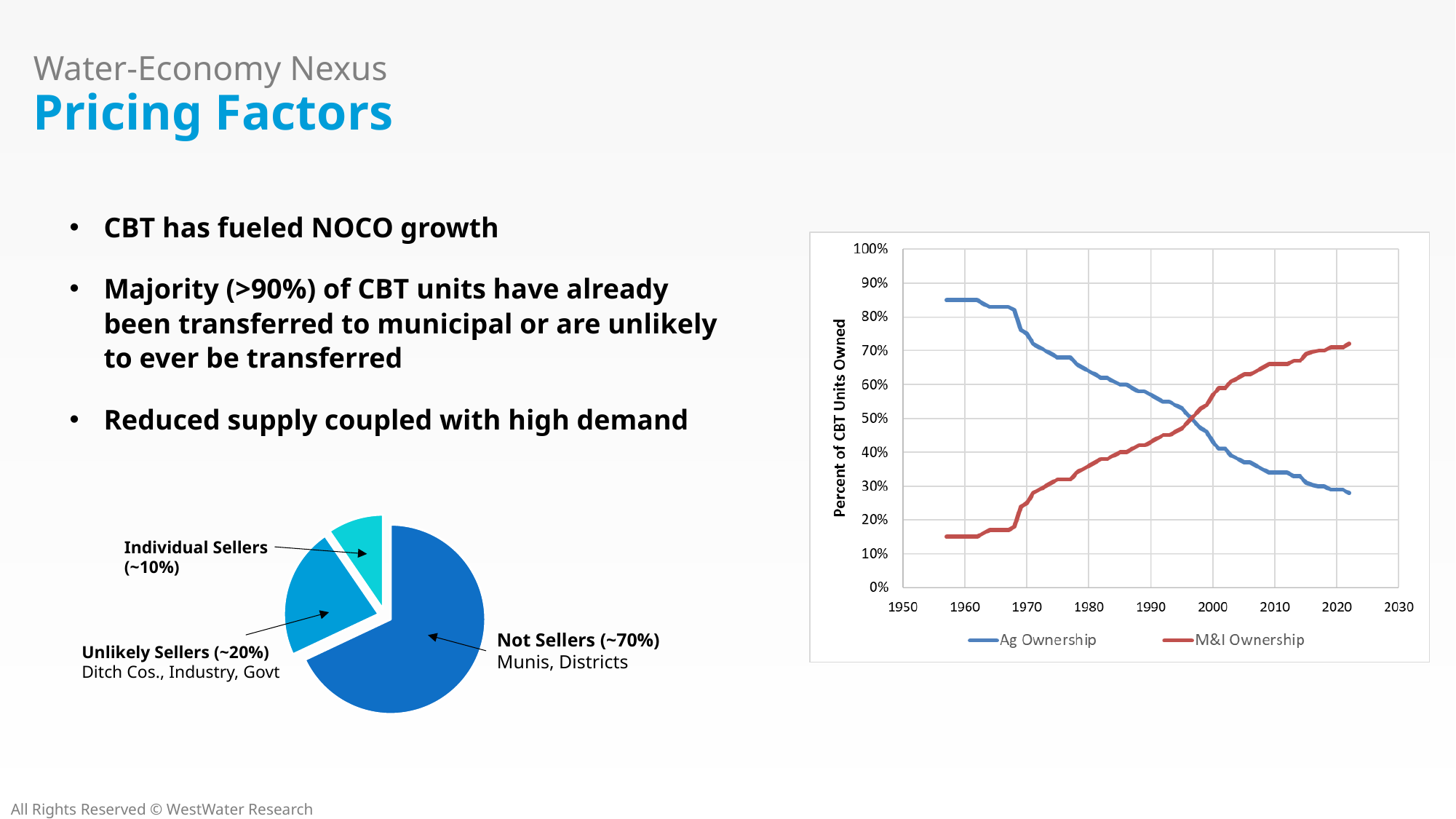
In the line chart on the right, does M&I Ownership rise or fall over time? rise What kind of chart is the chart on the right of the slide? line chart What kind of chart is the chart on the bottom left of the slide? pie chart In the line chart on the right, is the value for M&I Ownership in 1960 greater or less than 20%? less In the line chart on the right, is the value for M&I Ownership in 2010 greater or less than 60%? greater In the line chart on the right, does Ag Ownership rise or fall over time? fall In the line chart on the right, which series has the higher value in 1970, Ag Ownership or M&I Ownership? Ag Ownership In the line chart on the right, is the value for Ag Ownership in 1960 greater or less than 80%? greater In the line chart on the right, what is the label of the vertical axis? Percent of CBT Units Owned In the line chart on the right, which series has the higher value in 2020, Ag Ownership or M&I Ownership? M&I Ownership In the line chart on the right, how many series does the legend list? 2 In the pie chart on the bottom left, which slice is the largest? Not Sellers